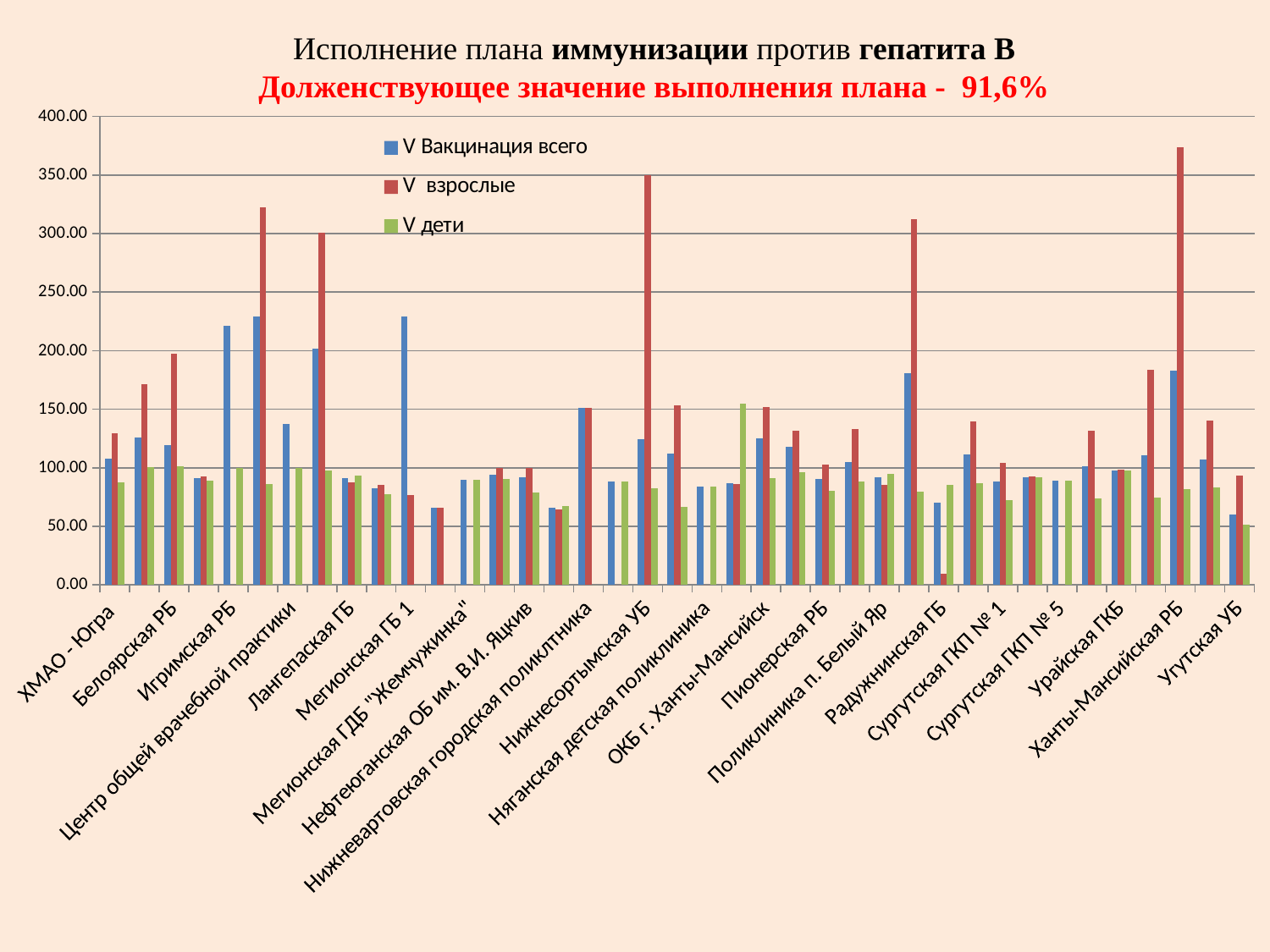
Which series has the tallest bar anywhere on the chart? V взрослые How many series does the legend list? 3 Is the value of V дети for ХМАО - Югра greater or less than 100? less Is the value of V взрослые for ХМАО - Югра greater or less than 100? greater Is the tallest bar of the V взрослые series greater or less than 350? greater For ХМАО - Югра, which is larger: V взрослые or V дети? V взрослые What target value for plan fulfilment is stated in the chart title? 91,6% What kind of chart is shown on the slide? bar chart What are the three series named in the legend? V Вакцинация всего, V взрослые, V дети